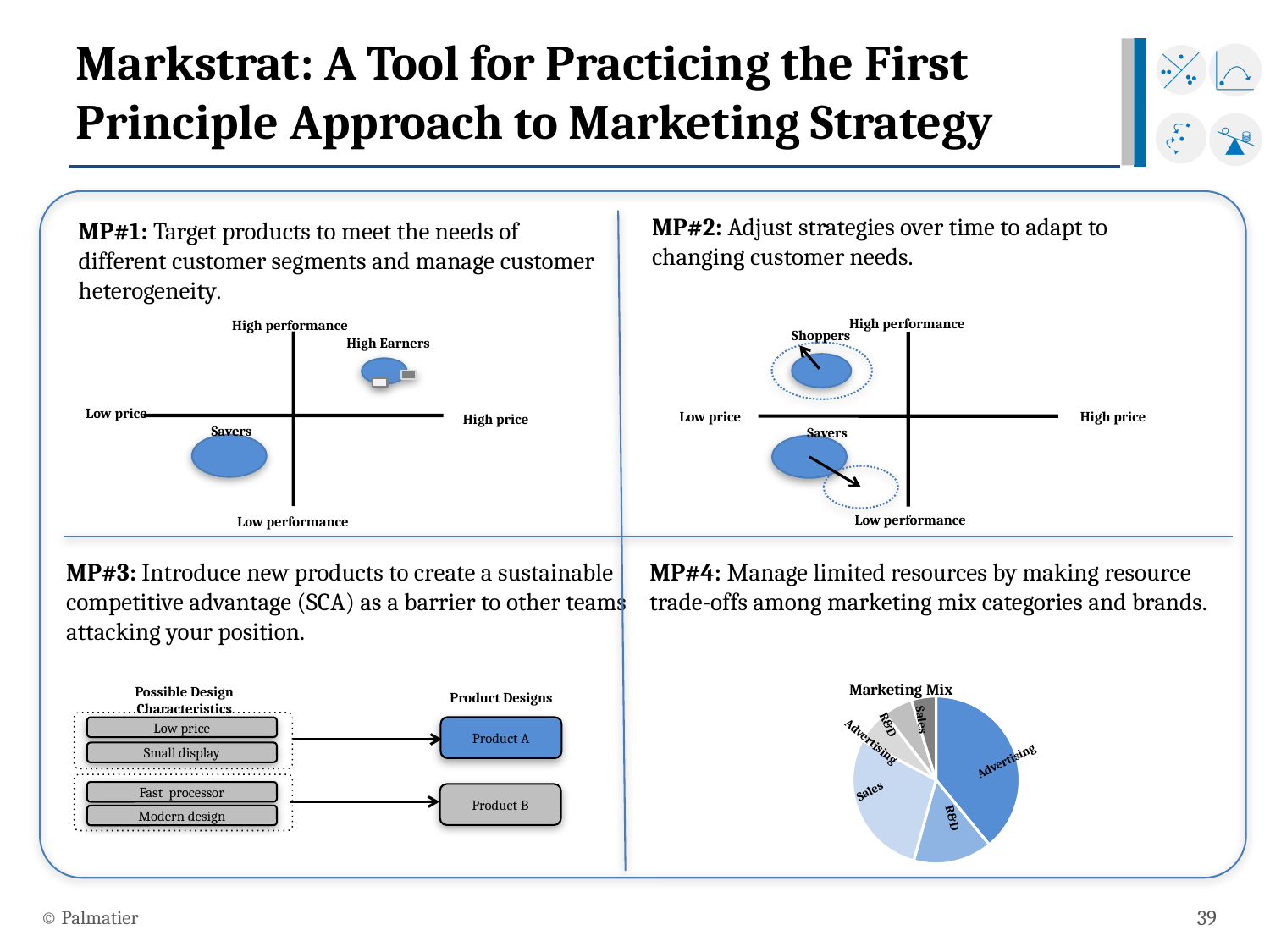
In the Marketing Mix pie chart, which is larger: the large dark blue Advertising slice or the R&D slice next to it? Advertising How many distinct category names are used to label the slices of the Marketing Mix pie chart? 3 What kind of chart is shown under MP#4 on the slide? pie chart What is the title of the pie chart under MP#4? Marketing Mix Does the Marketing Mix pie chart display percentage values on its slices? No Which slice is the largest in the Marketing Mix pie chart? Advertising How many slices does the Marketing Mix pie chart have? 6